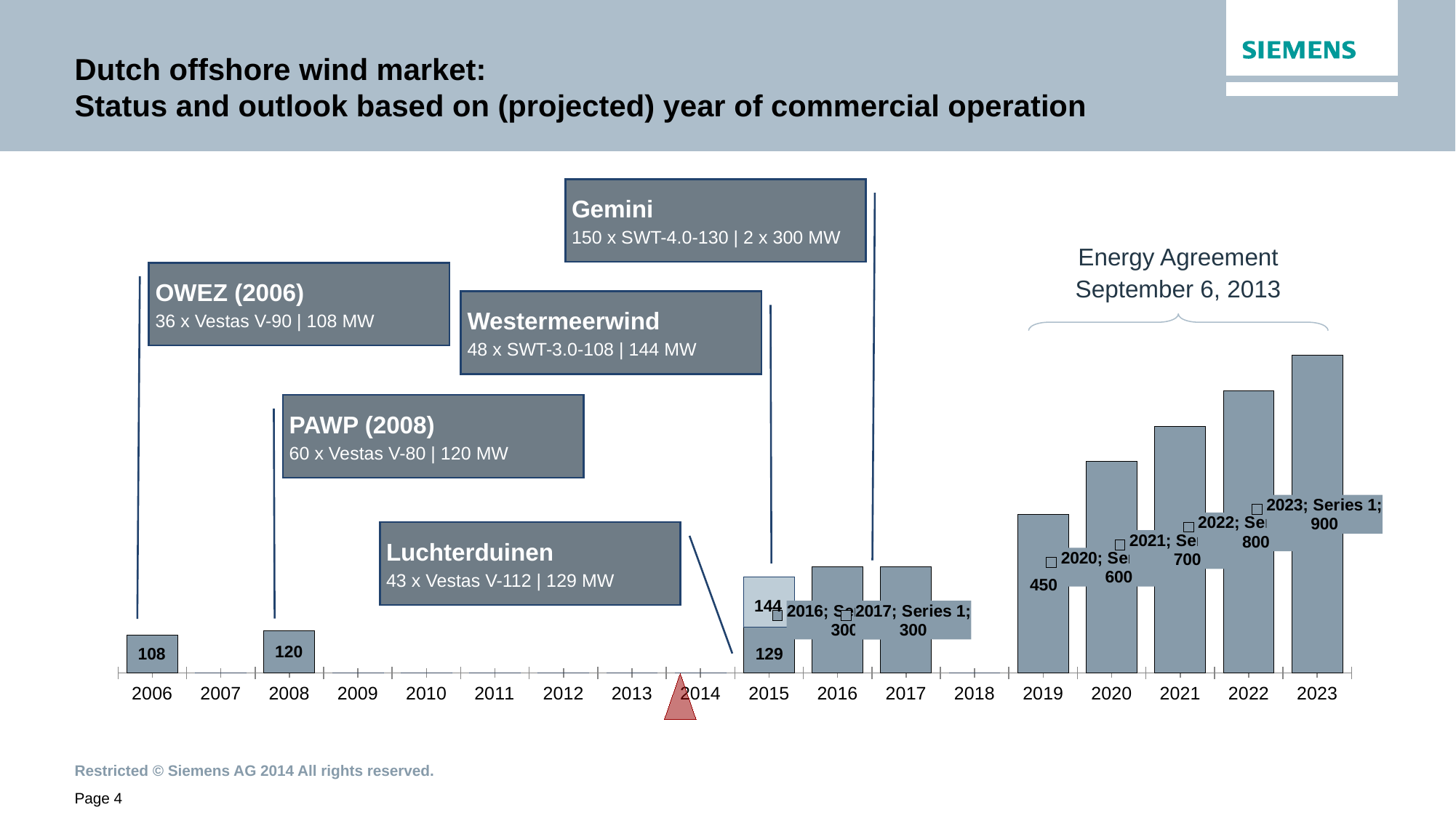
How many years are labelled along the x axis of the chart? 18 Which year has the tallest bar in the chart? 2023 Which year has the smallest labelled bar value in the chart? 2006 Do the bar values rise or fall from 2019 to 2023? rise What value is labelled on the bar for 2023? 900 What is the total of the stacked bar for 2015 (129 plus 144)? 273 What value is labelled on the bar for 2019? 450 Which is larger, the value for 2020 or the value for 2016? 2020 What kind of chart is shown on the slide? bar chart What is the difference between the labelled values for 2023 and 2019? 450 What value is labelled on the bar for 2008? 120 What value is labelled on the bar for 2006? 108